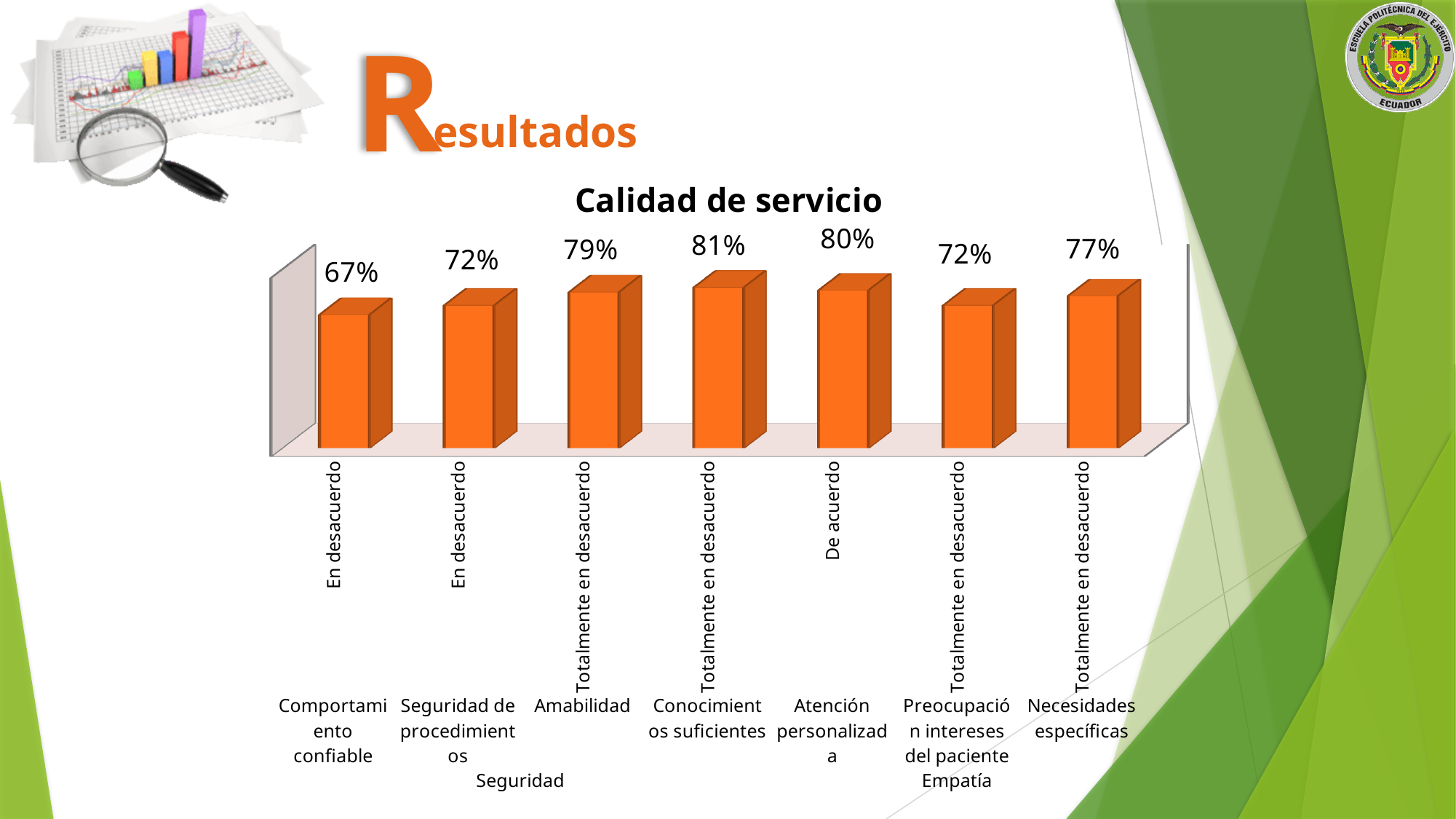
Which is larger, the value for Amabilidad or the value for Necesidades específicas? Amabilidad Which category has the highest value? Conocimientos suficientes (81%) What is the value for Amabilidad? 79% What is the value for Necesidades específicas? 77% What is the value for Comportamiento confiable? 67% Which category has the lowest value? Comportamiento confiable (67%) What response label is shown above the Atención personalizada bar? De acuerdo What is the value for Atención personalizada? 80% What is the title of the chart? Calidad de servicio What is the difference between the highest value (Conocimientos suficientes) and the lowest value (Comportamiento confiable)? 14 percentage points How many bars (categories) does the chart show? 7 What type of chart is shown on the slide? Bar chart